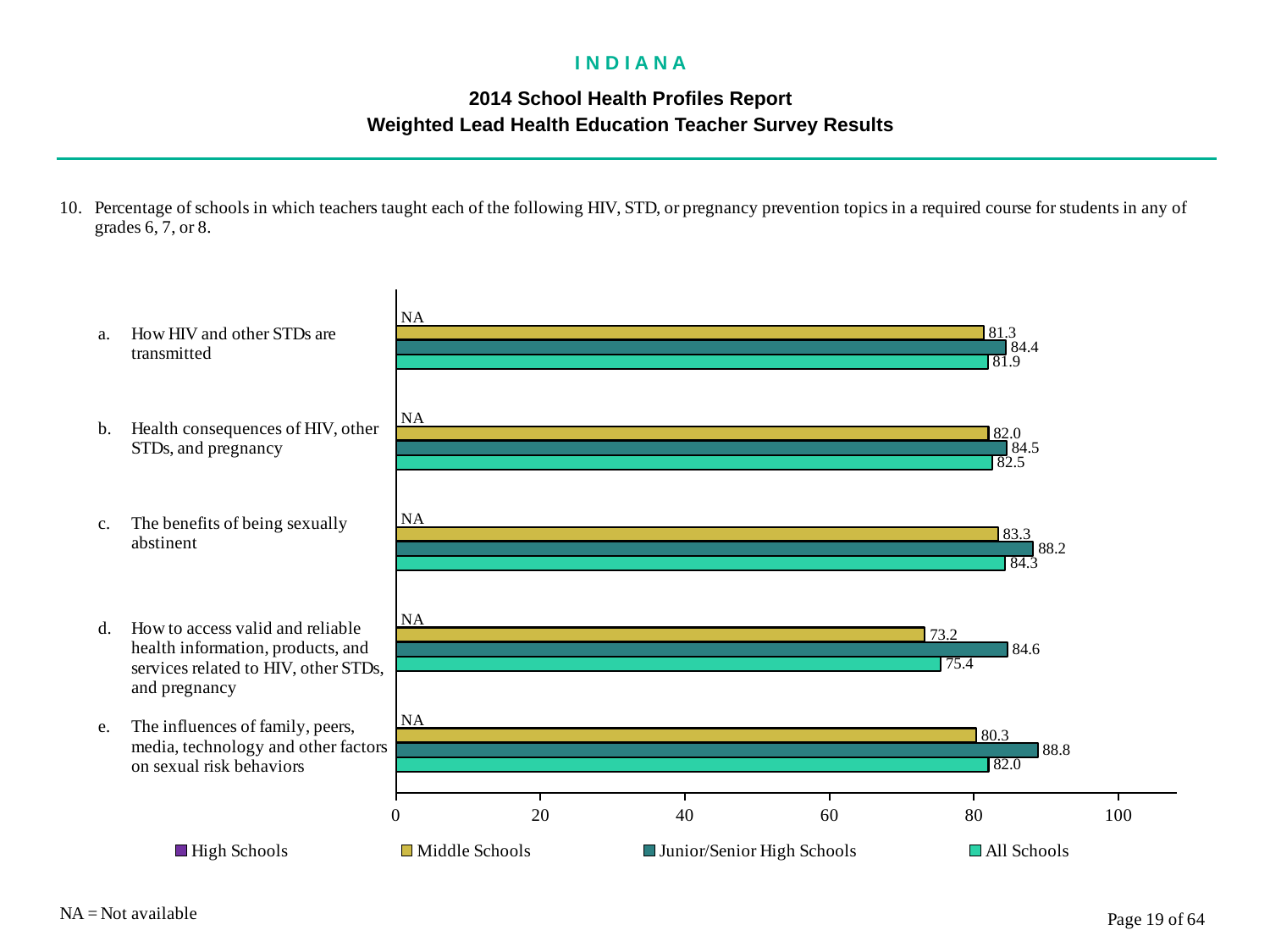
For topic c, which is larger: the Junior/Senior High Schools value or the All Schools value? Junior/Senior High Schools Is the Middle Schools value for topic d greater or less than 80? less What is the Middle Schools value for topic a, how HIV and other STDs are transmitted? 81.3 Which topic has the lowest Middle Schools value? d. How to access valid and reliable health information, products, and services related to HIV, other STDs, and pregnancy What is the Junior/Senior High Schools value for topic e, the influences of family, peers, media, technology and other factors on sexual risk behaviors? 88.8 What is the All Schools value for topic d, how to access valid and reliable health information, products, and services related to HIV, other STDs, and pregnancy? 75.4 Which topic has the highest Junior/Senior High Schools value? e. The influences of family, peers, media, technology and other factors on sexual risk behaviors What kind of chart is shown on the slide? bar chart How many topics are listed on the chart? 5 What is shown for High Schools for topic c, the benefits of being sexually abstinent? NA How many series does the legend list? 4 What is the difference between the Junior/Senior High Schools and Middle Schools values for topic d? 11.4